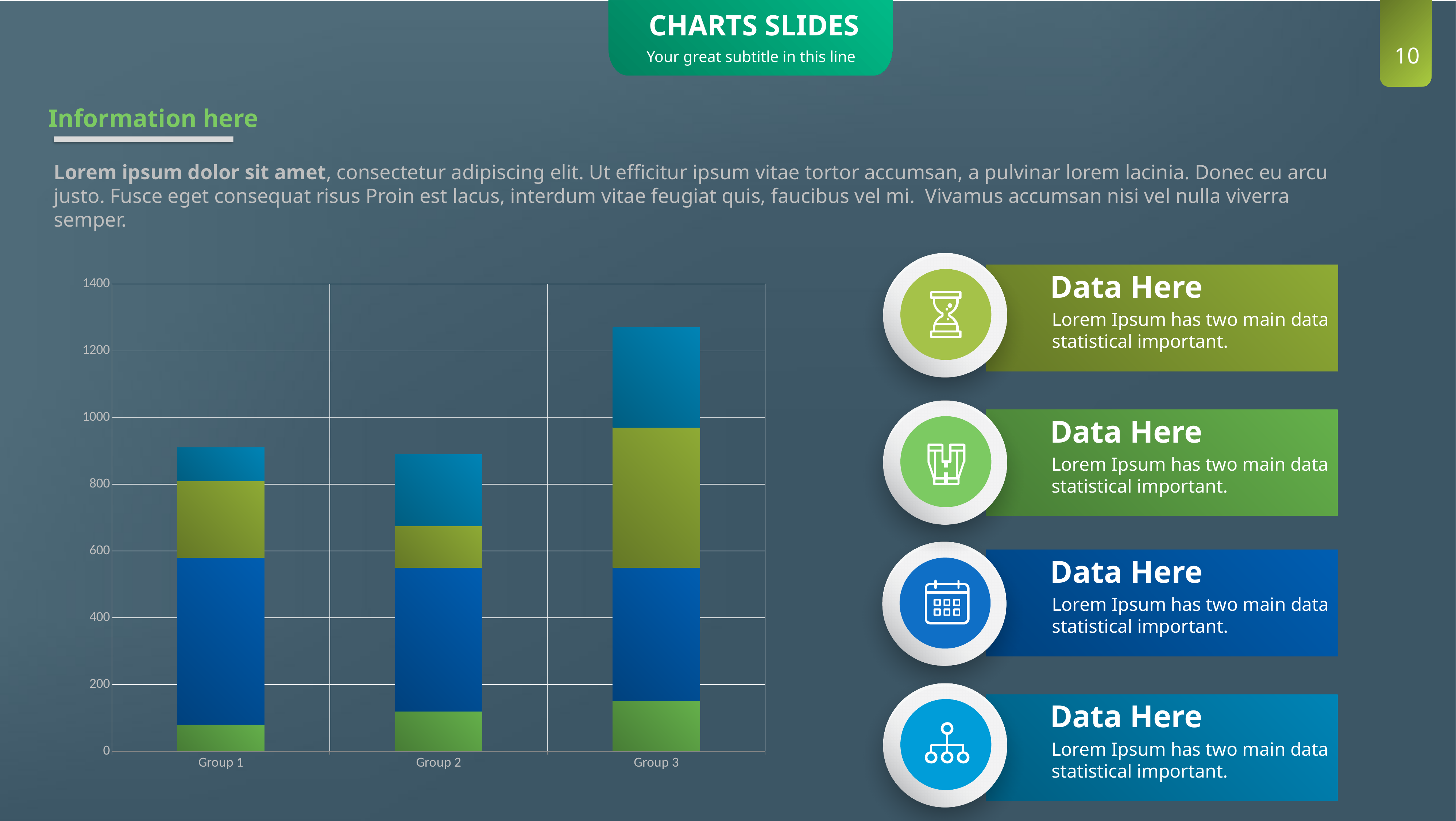
Which group has the tallest stacked bar in the chart? Group 3 Is the total stacked value for Group 1 greater or less than 1000? less Is the total stacked value for Group 3 greater or less than 1200? greater Is the total stacked value for Group 2 greater or less than 800? greater What are the category labels on the x axis of the chart? Group 1, Group 2, Group 3 Which is larger, the total stacked bar for Group 3 or for Group 2? Group 3 How many groups are shown on the x axis of the chart? 3 What kind of chart is shown on the slide? stacked bar chart How many coloured segments make up each stacked bar in the chart? 4 What is the highest value shown on the chart's y axis? 1400